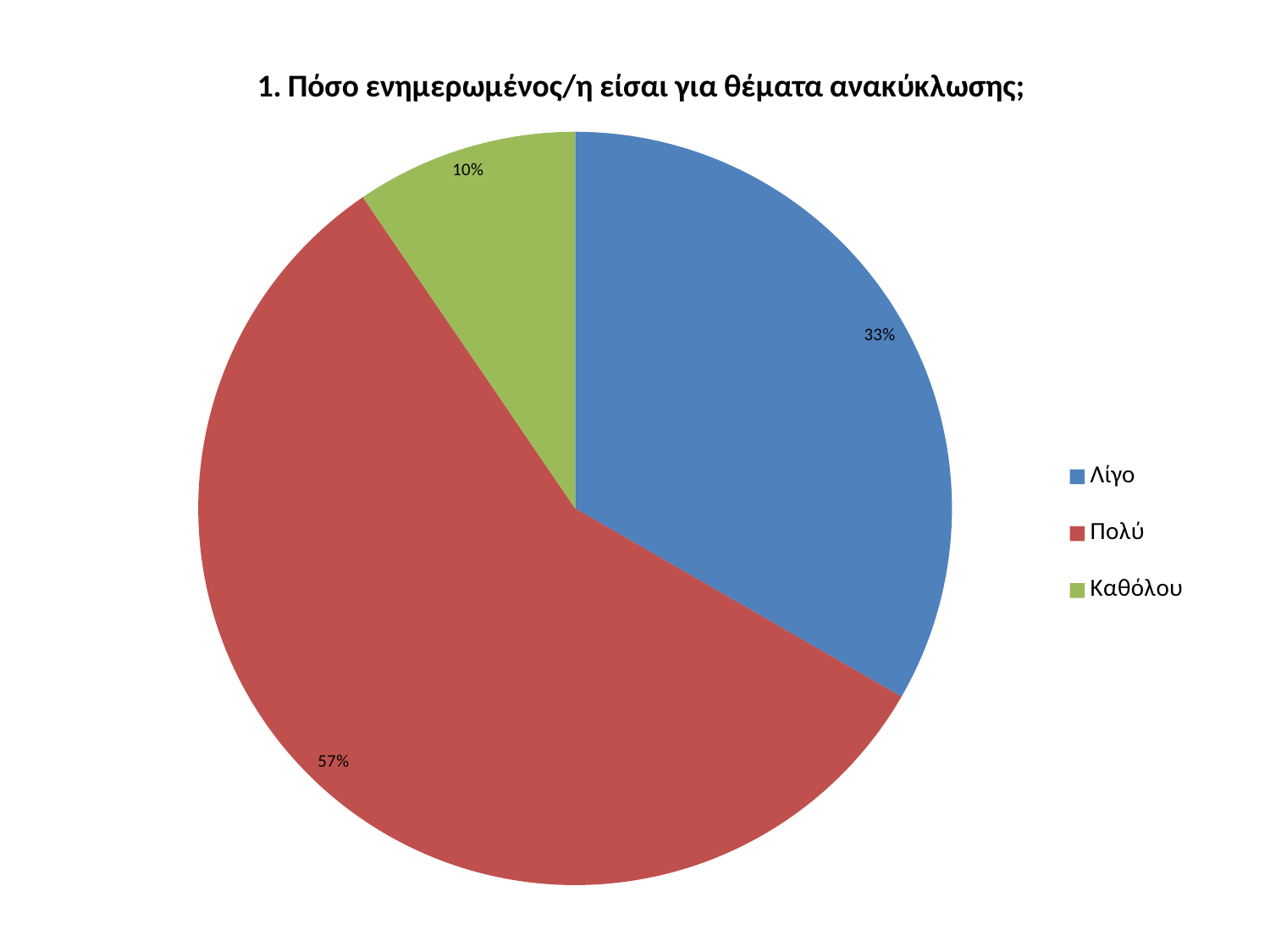
Which category has the largest slice of the pie? Πολύ What is the difference in percentage points between Πολύ and Λίγο? 24 What is the title of the chart? 1. Πόσο ενημερωμένος/η είσαι για θέματα ανακύκλωσης; Which colour represents Καθόλου in the legend? Green Which category has the smallest slice of the pie? Καθόλου What share of the pie does Καθόλου represent? 10% What share of the pie does Πολύ represent? 57% Which is larger, the share for Λίγο or the share for Καθόλου? Λίγο What is the difference in percentage points between Λίγο and Καθόλου? 23 What share of the pie does Λίγο represent? 33% How many categories does the pie chart show? 3 What kind of chart is shown on the slide? Pie chart